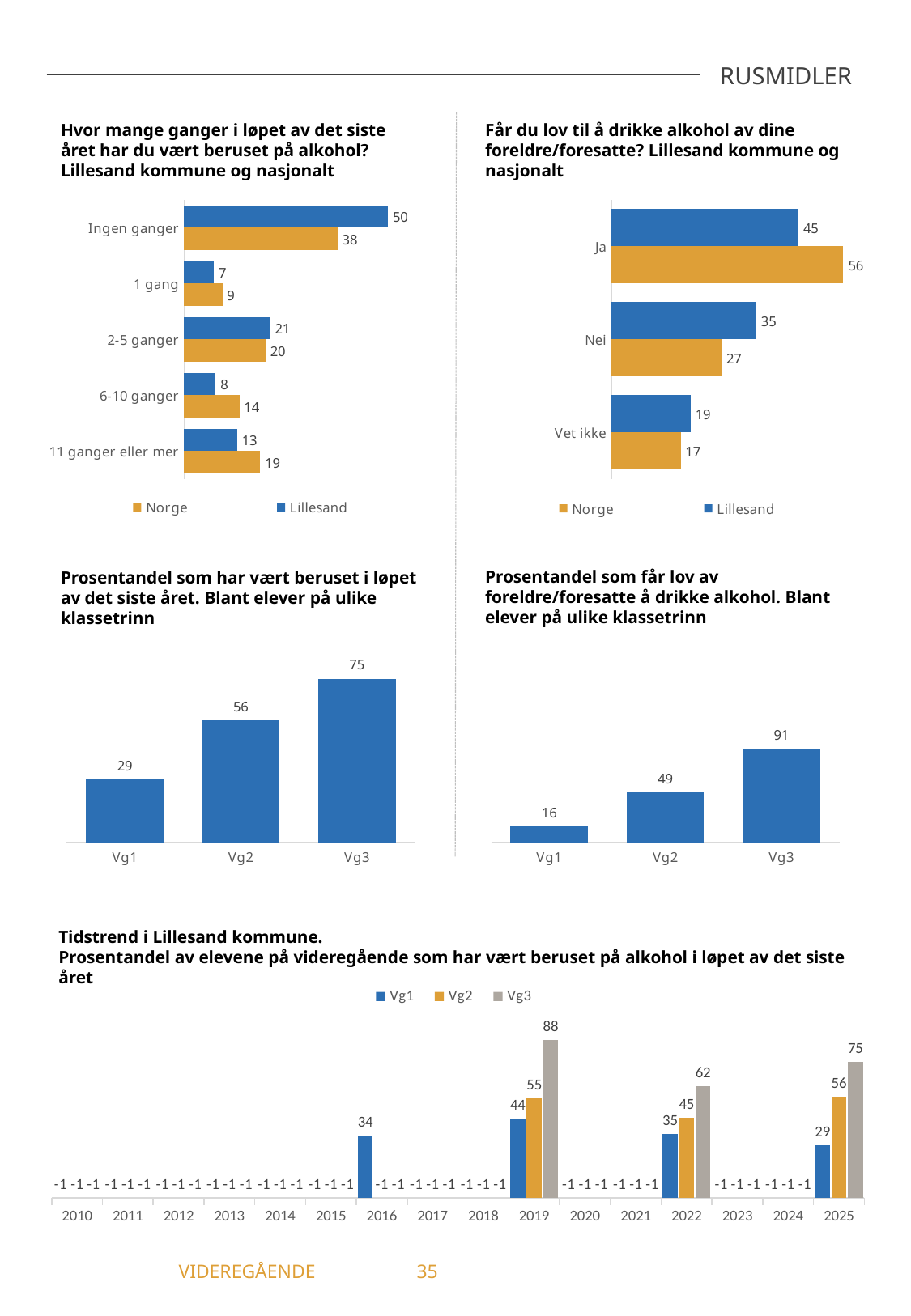
In the top-right chart 'Får du lov til å drikke alkohol av dine foreldre/foresatte?', which is larger for 'Nei': Lillesand or Norge? Lillesand In the middle-left chart 'Prosentandel som har vært beruset i løpet av det siste året', do the values rise or fall from Vg1 to Vg3? rise In the top-left chart 'Hvor mange ganger i løpet av det siste året har du vært beruset på alkohol?', what is the value for Lillesand for 'Ingen ganger'? 50 In the top-right chart 'Får du lov til å drikke alkohol av dine foreldre/foresatte?', what is the value for Norge for 'Ja'? 56 In the top-left chart 'Hvor mange ganger i løpet av det siste året har du vært beruset på alkohol?', what is the difference between the Norge and Lillesand values for '6-10 ganger'? 6 In the middle-right chart 'Prosentandel som får lov av foreldre/foresatte å drikke alkohol', what is the difference between Vg3 and Vg1? 75 In the middle-left chart 'Prosentandel som har vært beruset i løpet av det siste året', what is the value for Vg2? 56 In the top-left chart 'Hvor mange ganger i løpet av det siste året har du vært beruset på alkohol?', how many categories are shown? 5 In the top-right chart 'Får du lov til å drikke alkohol av dine foreldre/foresatte?', how many series does the legend list? 2 In the middle-right chart 'Prosentandel som får lov av foreldre/foresatte å drikke alkohol', which klassetrinn has the highest value? Vg3 What kind of chart is the bottom chart 'Tidstrend i Lillesand kommune'? bar chart In the bottom chart 'Tidstrend i Lillesand kommune', what is the value for Vg3 in 2019? 88